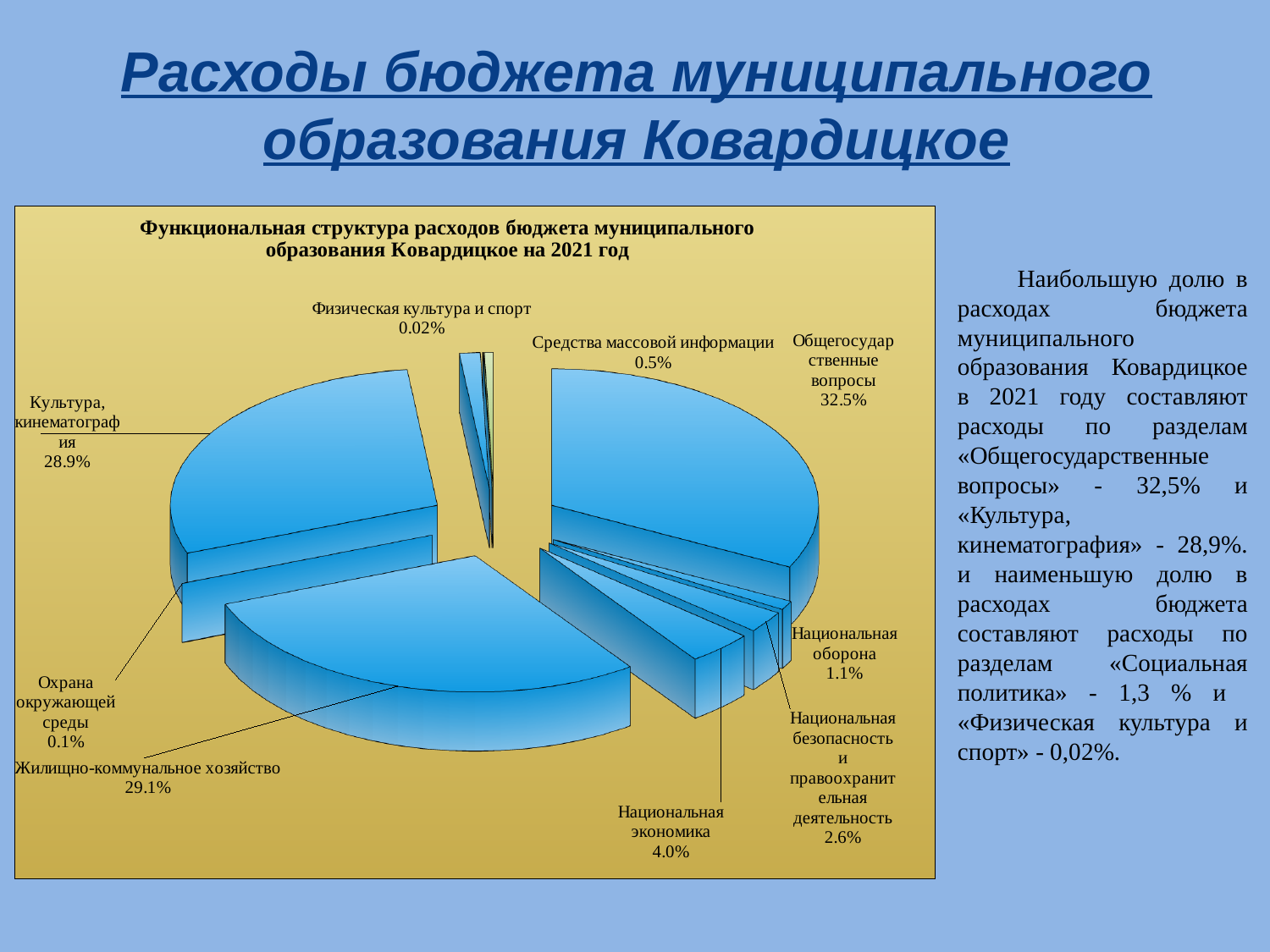
What share is shown for Физическая культура и спорт? 0.02% What is the title of the chart? Функциональная структура расходов бюджета муниципального образования Ковардицкое на 2021 год Which is larger: the share for Жилищно-коммунальное хозяйство or for Культура, кинематография? Жилищно-коммунальное хозяйство What share is shown for Жилищно-коммунальное хозяйство? 29.1% What share of expenditures is labelled for Общегосударственные вопросы? 32.5% Which category has the smallest share in the pie chart? Физическая культура и спорт What share is shown for Национальная экономика? 4.0% What share is shown for Культура, кинематография? 28.9% What is the difference in percentage points between Общегосударственные вопросы and Культура, кинематография? 3.6 What share is shown for Национальная безопасность и правоохранительная деятельность? 2.6% Which category has the largest share in the pie chart? Общегосударственные вопросы What kind of chart is shown on the slide? pie chart